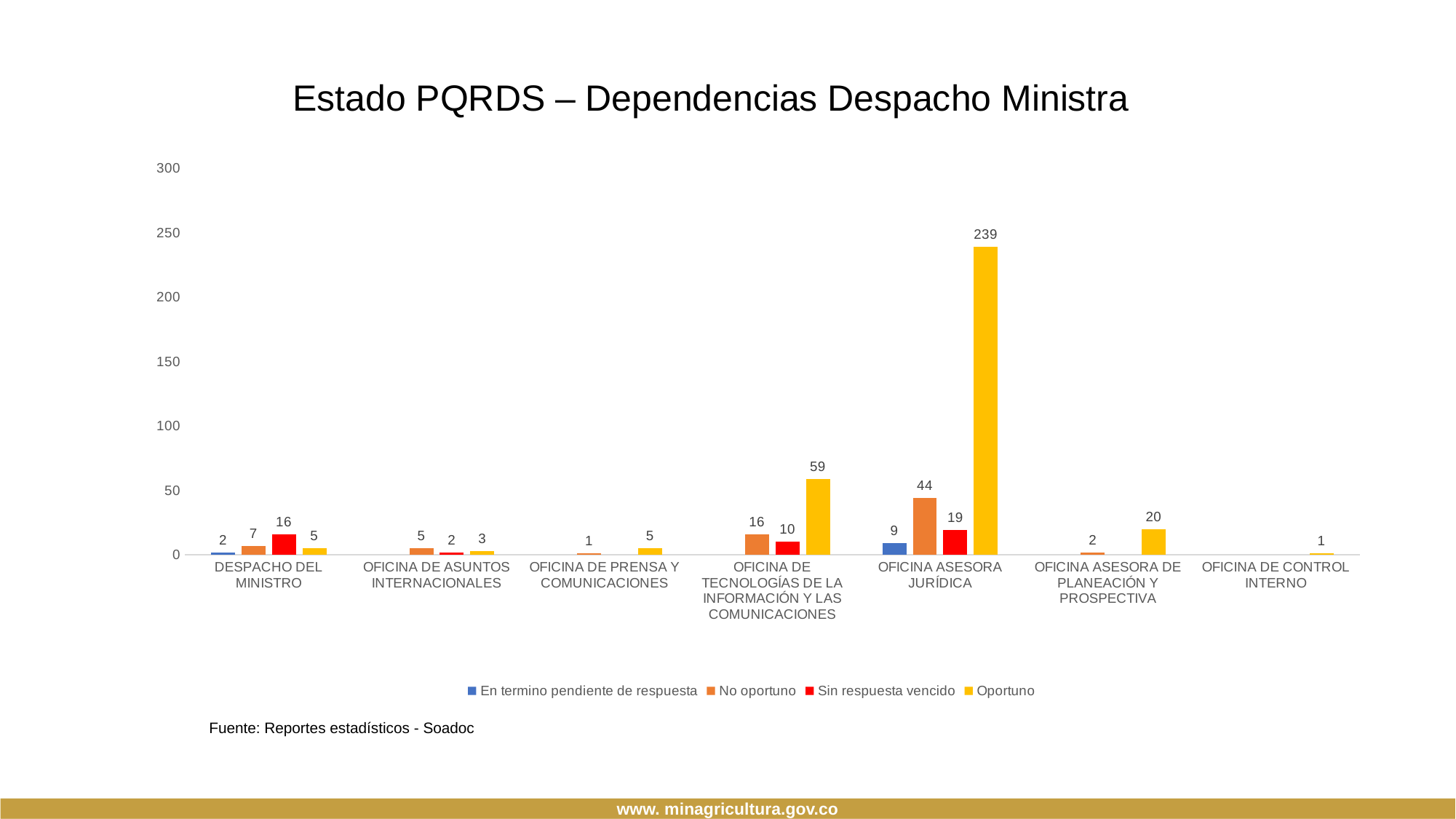
How many categories are shown on the x axis? 7 How many series does the legend list? 4 What kind of chart is shown on the slide? Bar chart What is the Sin respuesta vencido value for DESPACHO DEL MINISTRO? 16 What is the Oportuno value for OFICINA ASESORA JURÍDICA? 239 Which category has the lowest Oportuno value? OFICINA DE CONTROL INTERNO Which is larger for OFICINA ASESORA JURÍDICA: No oportuno or Sin respuesta vencido? No oportuno Is the Oportuno value for OFICINA ASESORA JURÍDICA greater or less than 200? greater What is the Oportuno value for OFICINA ASESORA DE PLANEACIÓN Y PROSPECTIVA? 20 Which category has the highest Oportuno value? OFICINA ASESORA JURÍDICA What is the No oportuno value for OFICINA DE TECNOLOGÍAS DE LA INFORMACIÓN Y LAS COMUNICACIONES? 16 What is the difference between the Oportuno values for OFICINA ASESORA JURÍDICA and OFICINA DE TECNOLOGÍAS DE LA INFORMACIÓN Y LAS COMUNICACIONES? 180